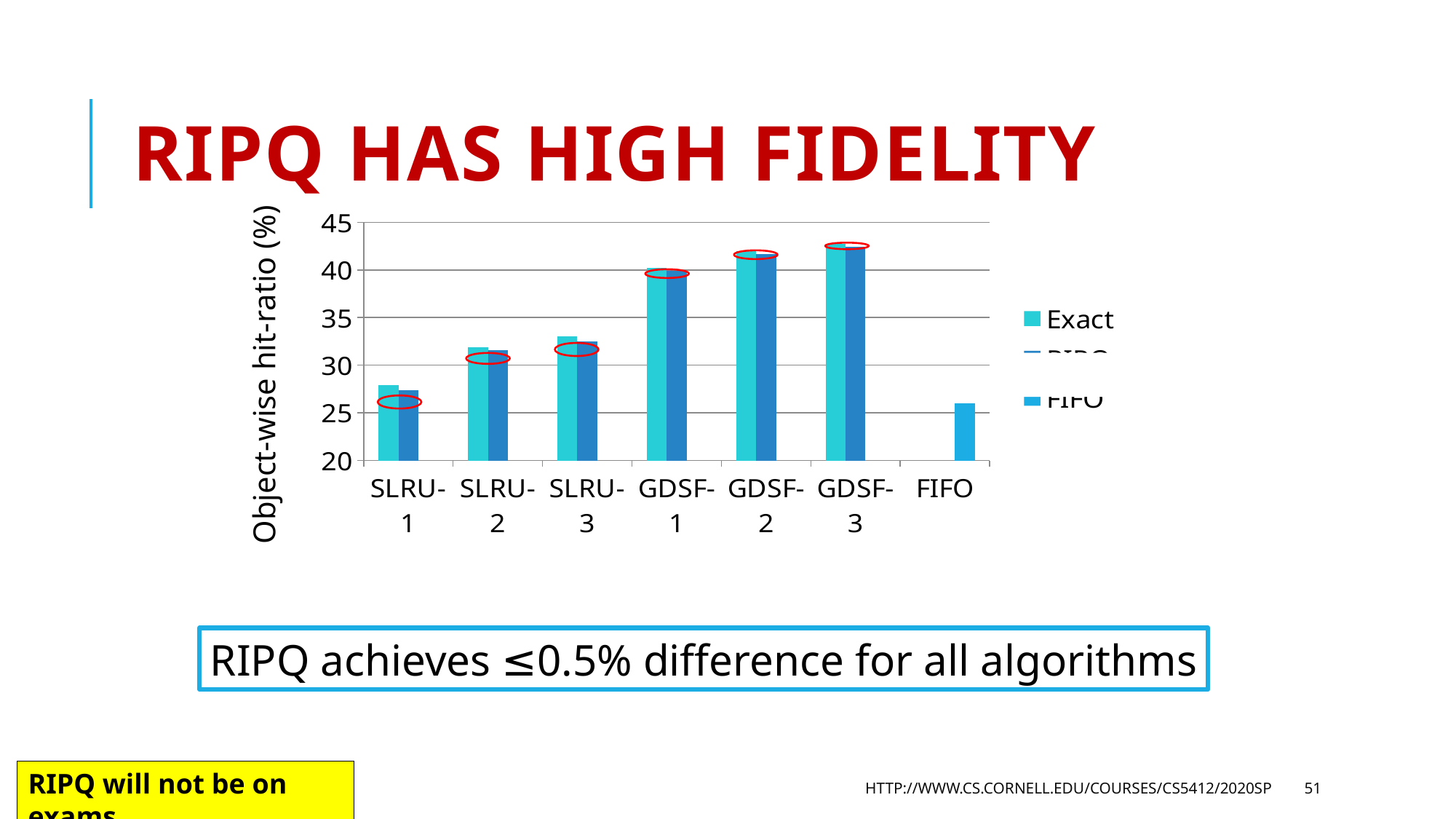
Is the Exact value for GDSF-1 greater or less than 35? greater Which category has the lowest Exact value? SLRU-1 What is the title of the slide containing the chart? RIPQ HAS HIGH FIDELITY Is the value of the FIFO bar greater or less than 30? less Is the Exact value for GDSF-3 greater or less than 40? greater How many categories are shown along the x axis of the chart? 7 Which has the larger Exact value, GDSF-1 or SLRU-3? GDSF-1 What kind of chart is shown on the slide? bar chart What is the label of the chart's vertical axis? Object-wise hit-ratio (%) Which category has the highest Exact value? GDSF-3